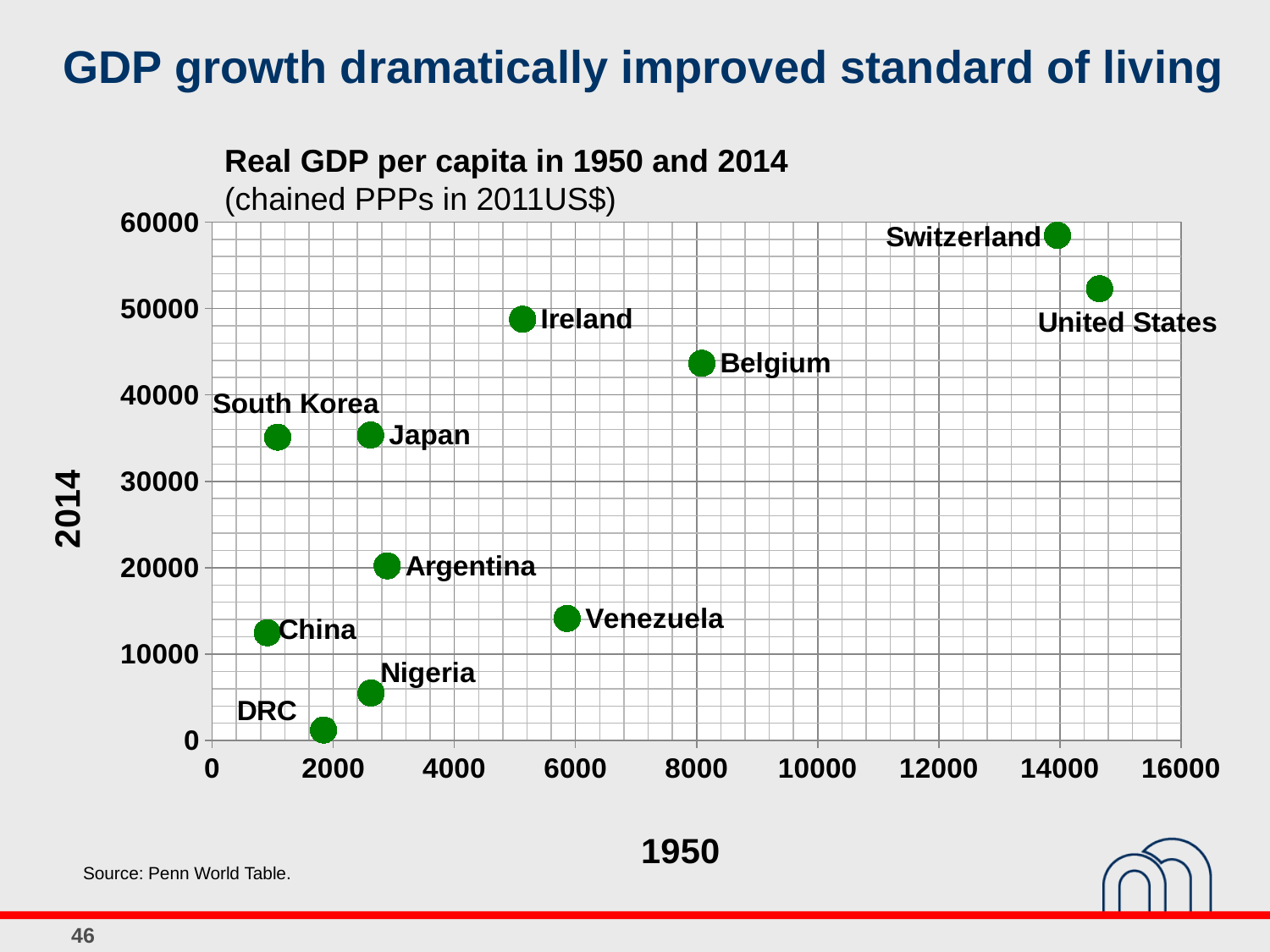
Which country has the lowest real GDP per capita in 2014? DRC Is the 1950 value for Venezuela greater or less than 8000? less How many countries are plotted on the chart? 11 What is the label of the vertical axis? 2014 Which has the larger 1950 value, Ireland or Belgium? Belgium Is the 2014 value for Ireland greater or less than 40000? greater Which has the larger 2014 value, Ireland or Belgium? Ireland What kind of chart is shown on the slide? scatter chart Which country has the highest real GDP per capita in 2014? Switzerland Is the 1950 value for Switzerland greater or less than 12000? greater Which country has the highest real GDP per capita in 1950? United States